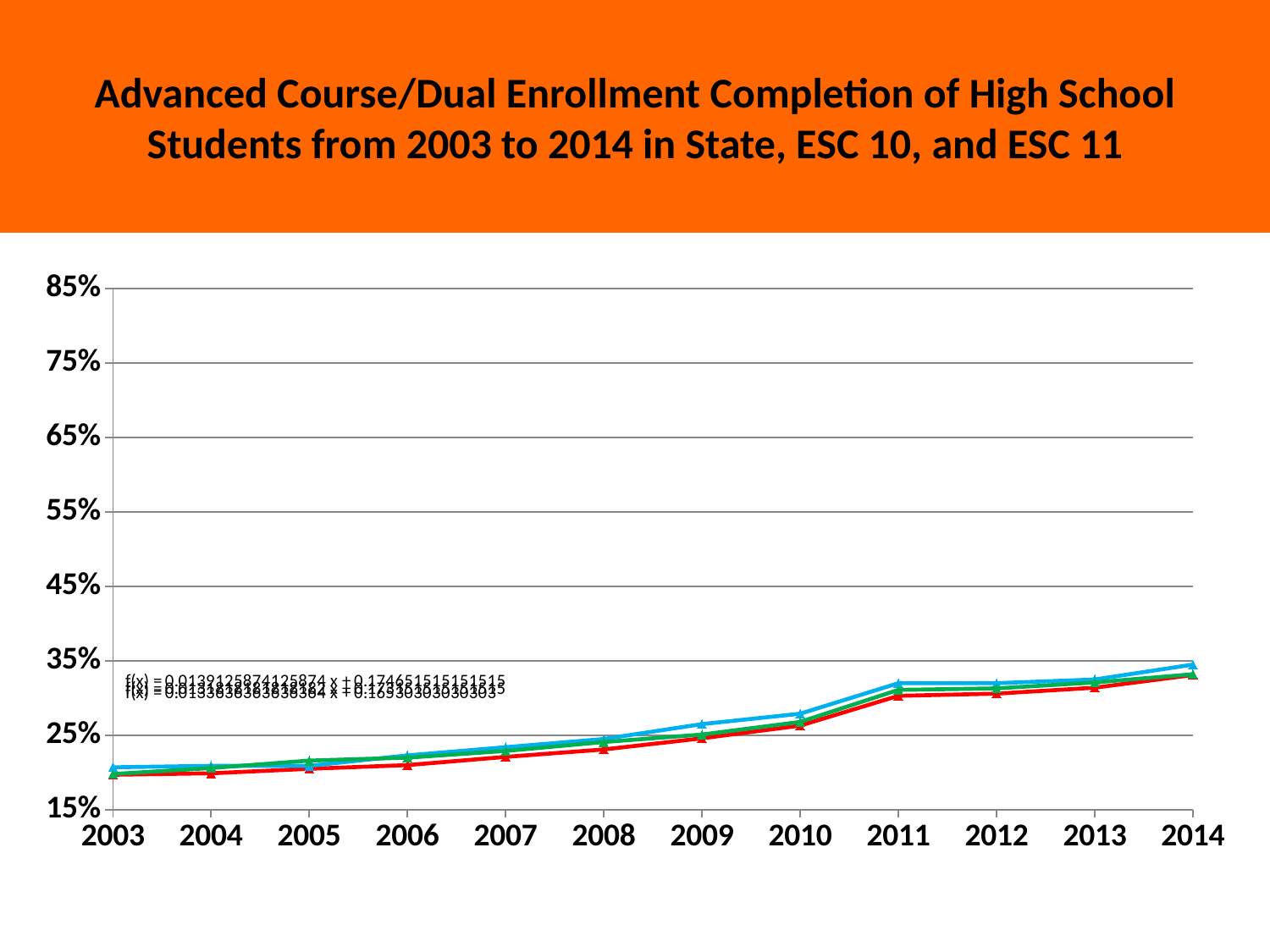
Do the plotted values generally rise or fall from 2003 to 2014? rise What is the title of the chart on the slide? Advanced Course/Dual Enrollment Completion of High School Students from 2003 to 2014 in State, ESC 10, and ESC 11 What kind of chart is shown on the slide? line chart Is the value of the red line in 2014 greater or less than 25%? greater In which year does the red line have its lowest value? 2003 How many years are shown along the x axis of the chart? 12 In which year does the blue line reach its highest value? 2014 Which is larger for the red line: the value in 2014 or the value in 2003? 2014 Is the value of the blue line in 2003 greater or less than 25%? less Is the value of the green line in 2011 greater or less than 25%? greater How many lines are plotted on the chart? 3